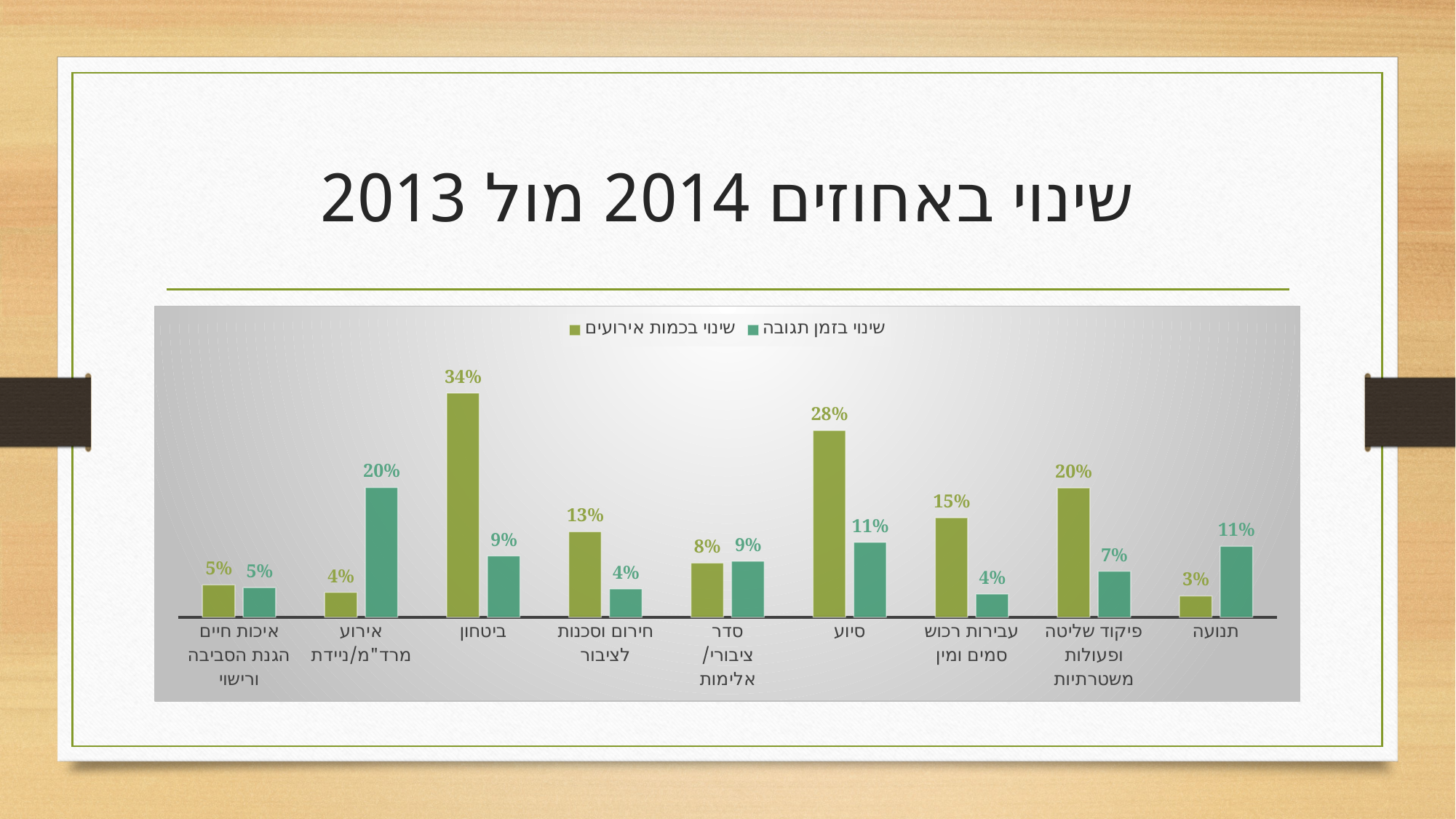
What is the difference between שינוי בכמות אירועים and שינוי בזמן תגובה for סיוע? 17% Which category has the lowest value for שינוי בכמות אירועים? תנועה What is the value of שינוי בכמות אירועים for תנועה? 3% How many categories are shown on the x axis? 9 Which category has the highest value for שינוי בזמן תגובה? אירוע מרד"מ/ניידת Which category has the highest value for שינוי בכמות אירועים? ביטחון For פיקוד שליטה ופעולות משטרתיות, which series has the larger value: שינוי בכמות אירועים or שינוי בזמן תגובה? שינוי בכמות אירועים What is the value of שינוי בזמן תגובה for אירוע מרד"מ/ניידת? 20% What is the value of שינוי בכמות אירועים for ביטחון? 34% What is the title of the slide? שינוי באחוזים 2014 מול 2013 What type of chart is shown on the slide? bar chart How many series does the legend list? 2